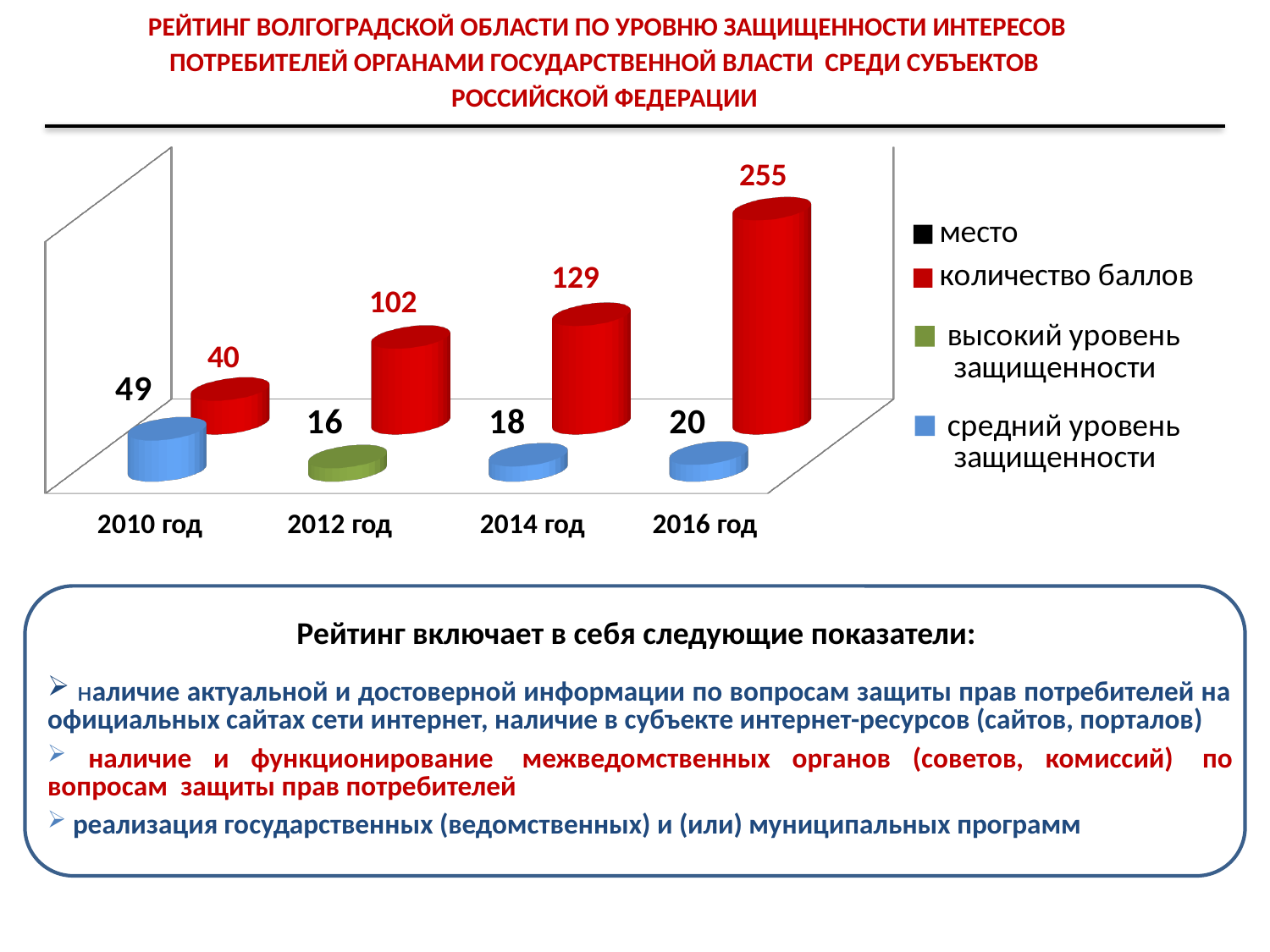
What is the value of "место" for 2014 год? 18 What is the value of "количество баллов" for 2012 год? 102 What is the difference in "количество баллов" between 2016 год and 2014 год? 126 In which year is "место" the lowest? 2012 год Does "количество баллов" rise or fall from 2010 год to 2016 год? rise Which is larger: "количество баллов" for 2012 год or for 2014 год? 2014 год What is the value of "место" for 2010 год? 49 In which year is "количество баллов" the highest? 2016 год How many years are shown on the x axis of the chart? 4 What kind of chart is shown on the slide? bar chart What is the value of "количество баллов" for 2016 год? 255 How many entries does the chart legend list? 4